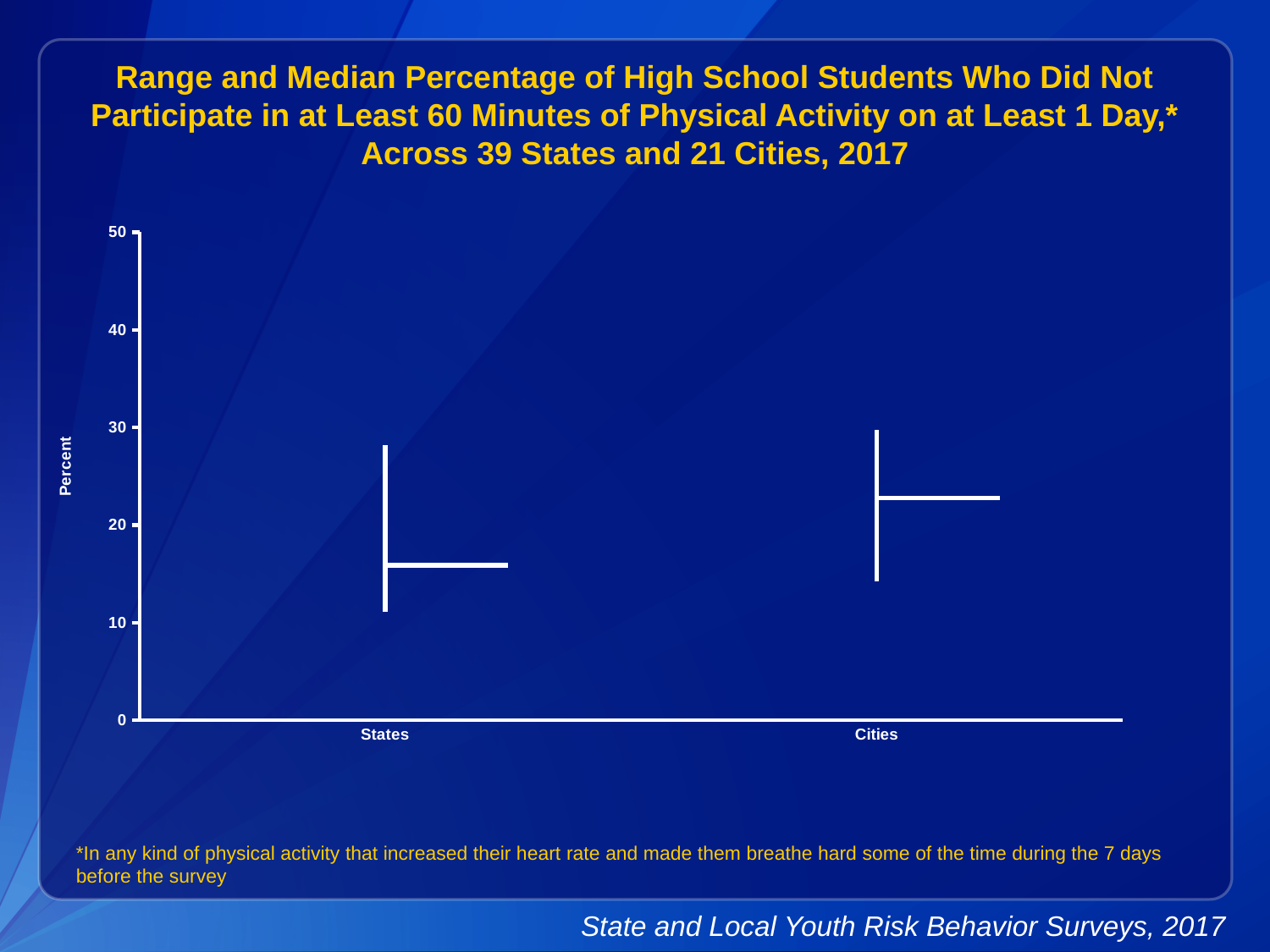
Is the top of the range for States greater or less than 30? less Is the median value for Cities greater or less than 20? greater Which category has the lower bottom of its range, States or Cities? States Is the bottom of the range for States greater or less than 10? greater How many categories are shown on the x axis of the chart? 2 Which category has the higher median percentage, States or Cities? Cities What is the highest value shown on the y axis? 50 What are the two categories shown on the x axis? States and Cities What is the label of the y axis? Percent